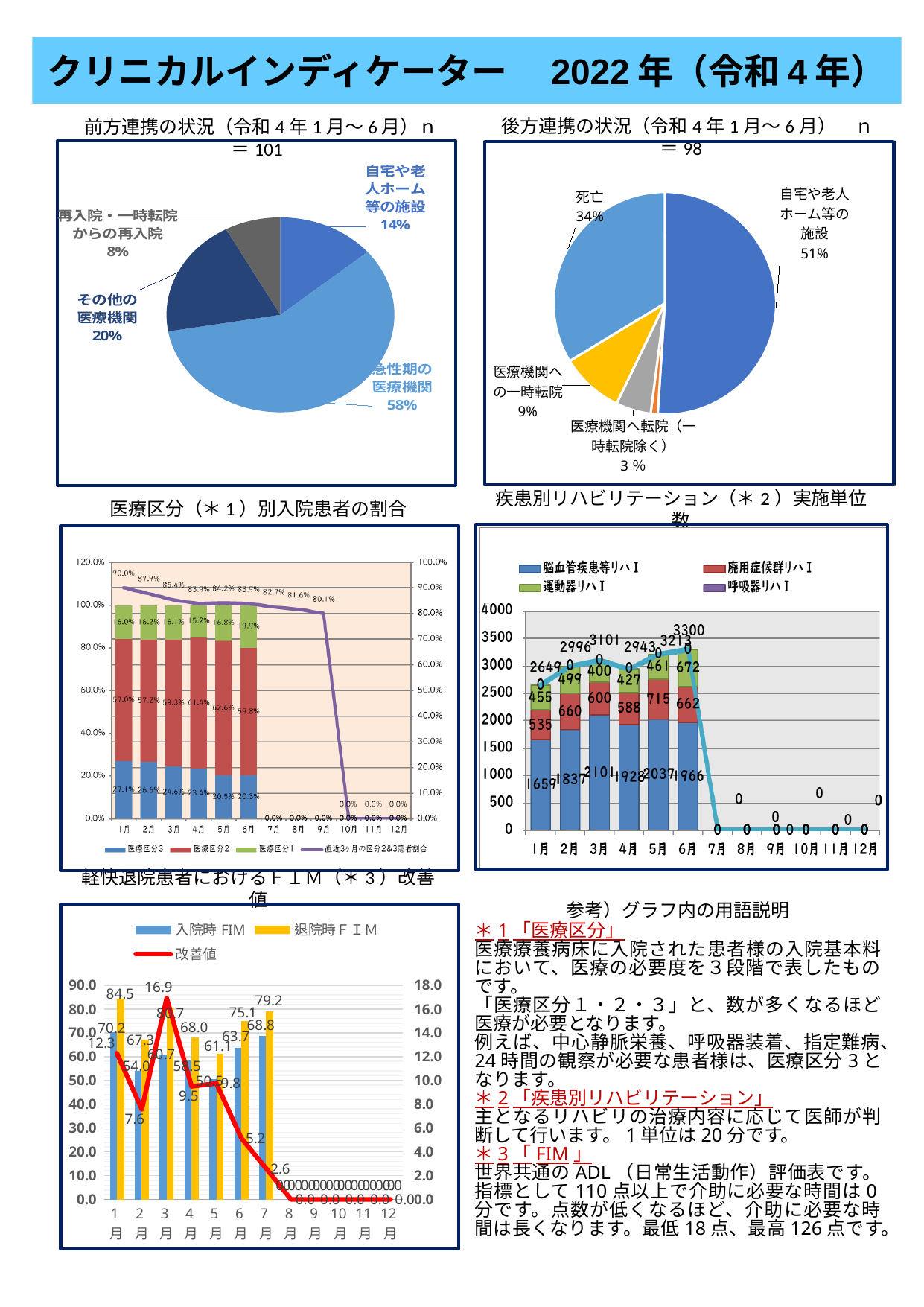
In the 軽快退院患者におけるFIM改善値 chart (bottom left), what is the 退院時FIM value for 1月? 84.5 In the 疾患別リハビリテーション実施単位数 chart (middle right), what is the total of the stacked bar for 6月? 3300 In the 後方連携の状況 pie chart (top right), what is the difference between the shares of 自宅や老人ホーム等の施設 and 死亡? 17% In the 前方連携の状況 pie chart (top left), which category has the smallest share? 再入院・一時転院からの再入院 In the 疾患別リハビリテーション実施単位数 chart (middle right), what is the value of 脳血管疾患等リハⅠ in 3月? 2101 In the 後方連携の状況 pie chart (top right), which category has the largest share? 自宅や老人ホーム等の施設 In the 医療区分別入院患者の割合 chart (middle left), what is the value of the 直近3ヶ月の区分2&3患者割合 line in 1月? 90.0% In the 後方連携の状況 pie chart (top right), what share is 死亡? 34% In the 疾患別リハビリテーション実施単位数 chart (middle right), how many series does the legend list? 4 In the 医療区分別入院患者の割合 chart (middle left), what is the value of 医療区分2 in 4月? 61.4% In the 前方連携の状況 pie chart (top left), what share is 急性期の医療機関? 58% In the 軽快退院患者におけるFIM改善値 chart (bottom left), which month has the highest 改善値? 3月